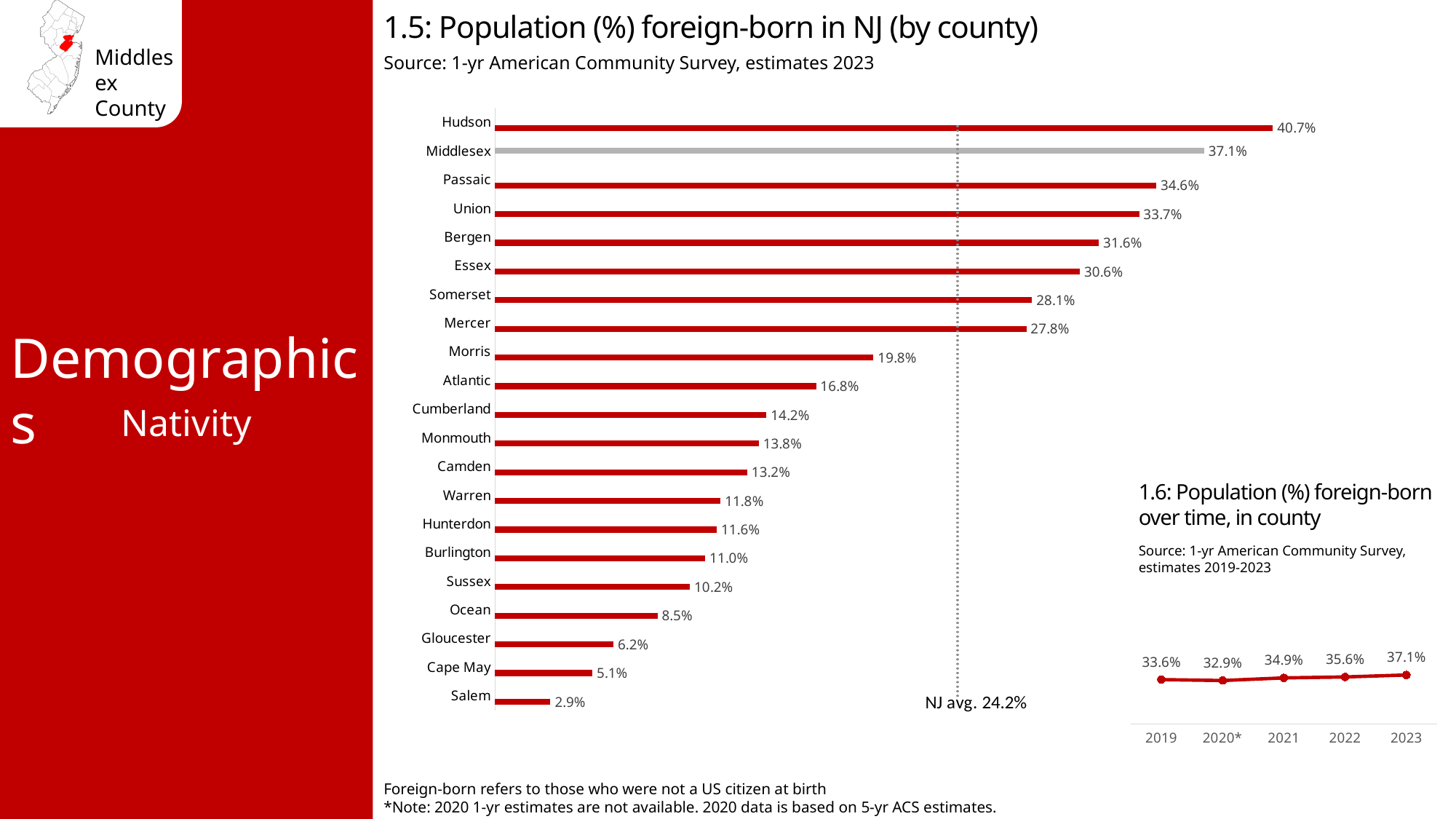
What kind of chart is chart 1.6 (Population (%) foreign-born over time, in county)? Line chart In chart 1.5 (Population (%) foreign-born in NJ by county), what is the NJ average shown by the dotted line? 24.2% In chart 1.6 (Population (%) foreign-born over time, in county), which year has the lowest value? 2020* In chart 1.5 (Population (%) foreign-born in NJ by county), which is larger, Bergen or Essex? Bergen In chart 1.5 (Population (%) foreign-born in NJ by county), what is the difference between Hudson and Middlesex? 3.6% In chart 1.5 (Population (%) foreign-born in NJ by county), which county has the highest value? Hudson In chart 1.6 (Population (%) foreign-born over time, in county), what is the value for 2021? 34.9% What kind of chart is chart 1.5 (Population (%) foreign-born in NJ by county)? Bar chart In chart 1.5 (Population (%) foreign-born in NJ by county), which county has the lowest value? Salem In chart 1.5 (Population (%) foreign-born in NJ by county), what is the value for Middlesex? 37.1% In chart 1.5 (Population (%) foreign-born in NJ by county), how many counties are shown? 21 In chart 1.6 (Population (%) foreign-born over time, in county), what is the difference between 2023 and 2019? 3.5%